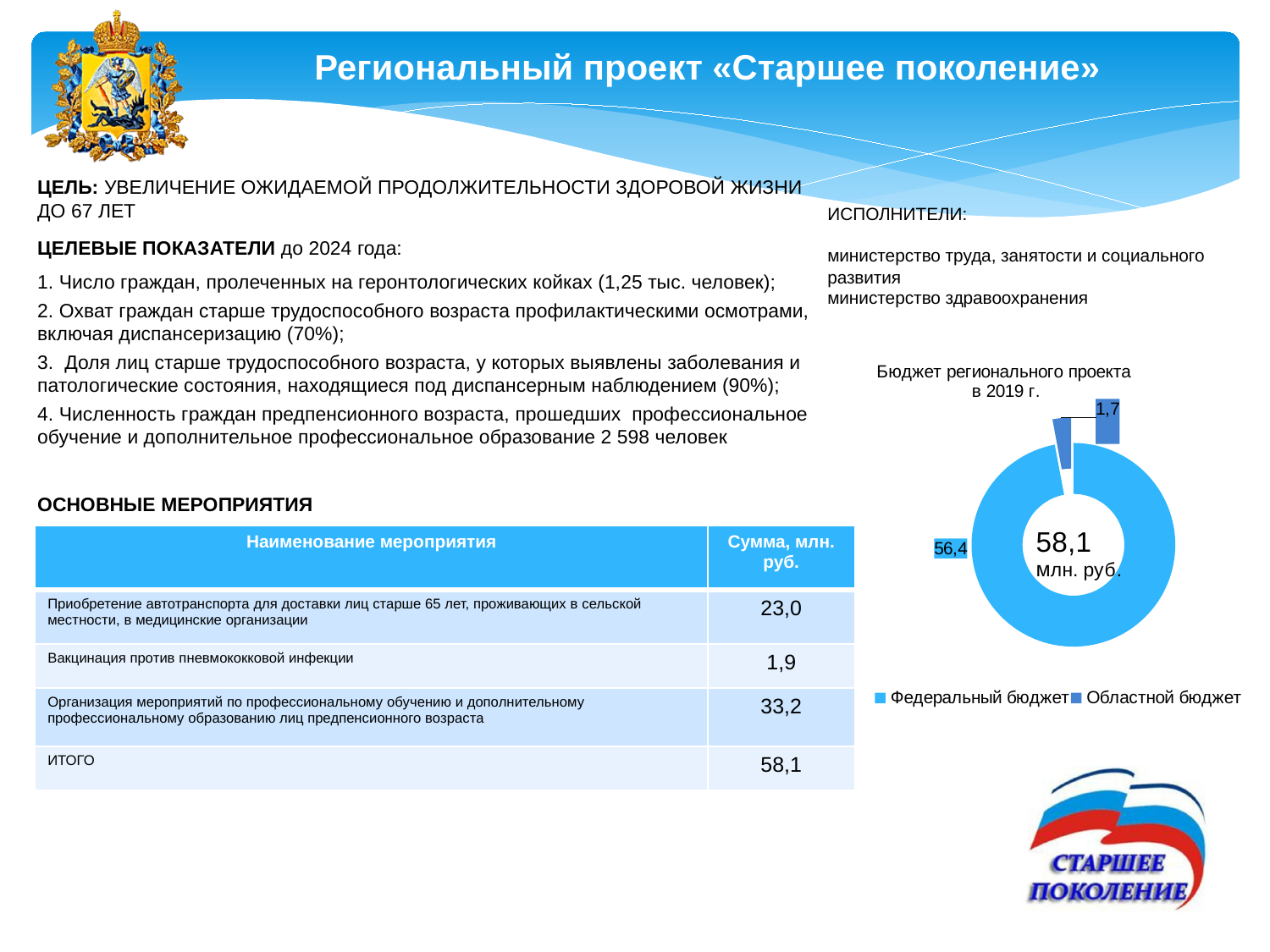
What total value is shown in the centre of the chart? 58,1 млн. руб. How many entries does the chart legend list? 2 What unit is shown in the centre of the chart? млн. руб. Which budget source has the smallest slice in the chart? Областной бюджет What is the difference between the Федеральный бюджет and Областной бюджет values in the chart? 54,7 What is the title of the chart on the slide? Бюджет регионального проекта в 2019 г. What kind of chart is shown on the slide? doughnut (pie) chart What is the value for Федеральный бюджет in the chart? 56,4 What is the value for Областной бюджет in the chart? 1,7 How many slices does the chart have? 2 Which budget source has the largest slice in the chart? Федеральный бюджет Which is larger in the chart: Федеральный бюджет or Областной бюджет? Федеральный бюджет